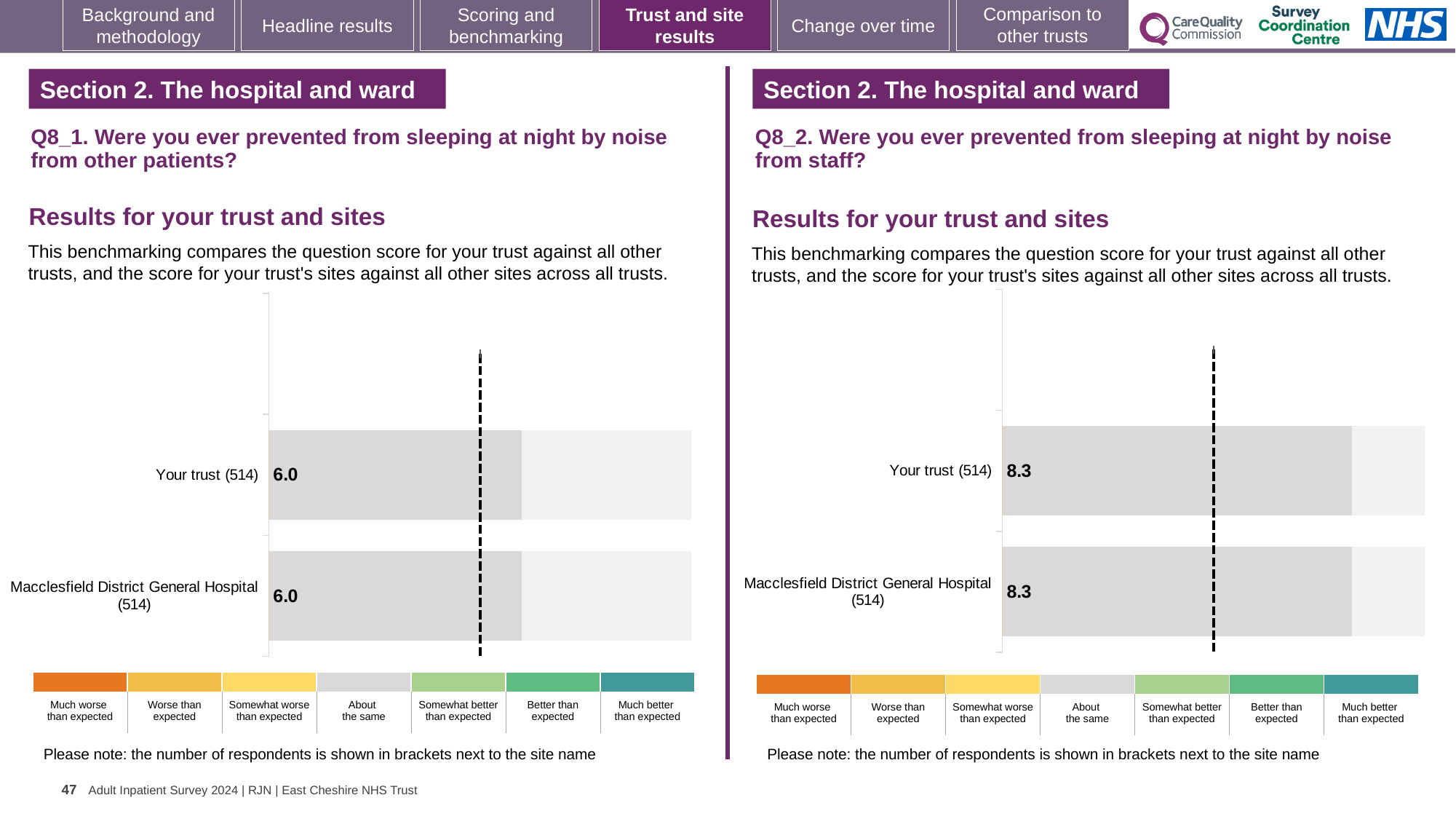
On the Q8_1 chart (left), what is the score for Macclesfield District General Hospital (514)? 6.0 In the colour key below the Q8_2 chart (right), which category is shown in orange at the far left? Much worse than expected On the Q8_1 chart (left), how many respondents are shown in brackets for Macclesfield District General Hospital? 514 What kind of chart is used for the Q8_2 results (right)? Bar chart On the Q8_2 chart (right), what is the score for Your trust (514)? 8.3 How many bars are plotted on the Q8_1 chart (left)? 2 How many rating categories does the colour key below the Q8_1 chart (left) list? 7 On the Q8_2 chart (right), what is the score for Macclesfield District General Hospital (514)? 8.3 On the Q8_2 chart (right), what is the difference between the score for Your trust and the score for Macclesfield District General Hospital? 0.0 How many bars are plotted on the Q8_2 chart (right)? 2 On the Q8_1 chart (left), what is the score for Your trust (514)? 6.0 On the Q8_1 chart (left), what is the difference between the score for Your trust and the score for Macclesfield District General Hospital? 0.0